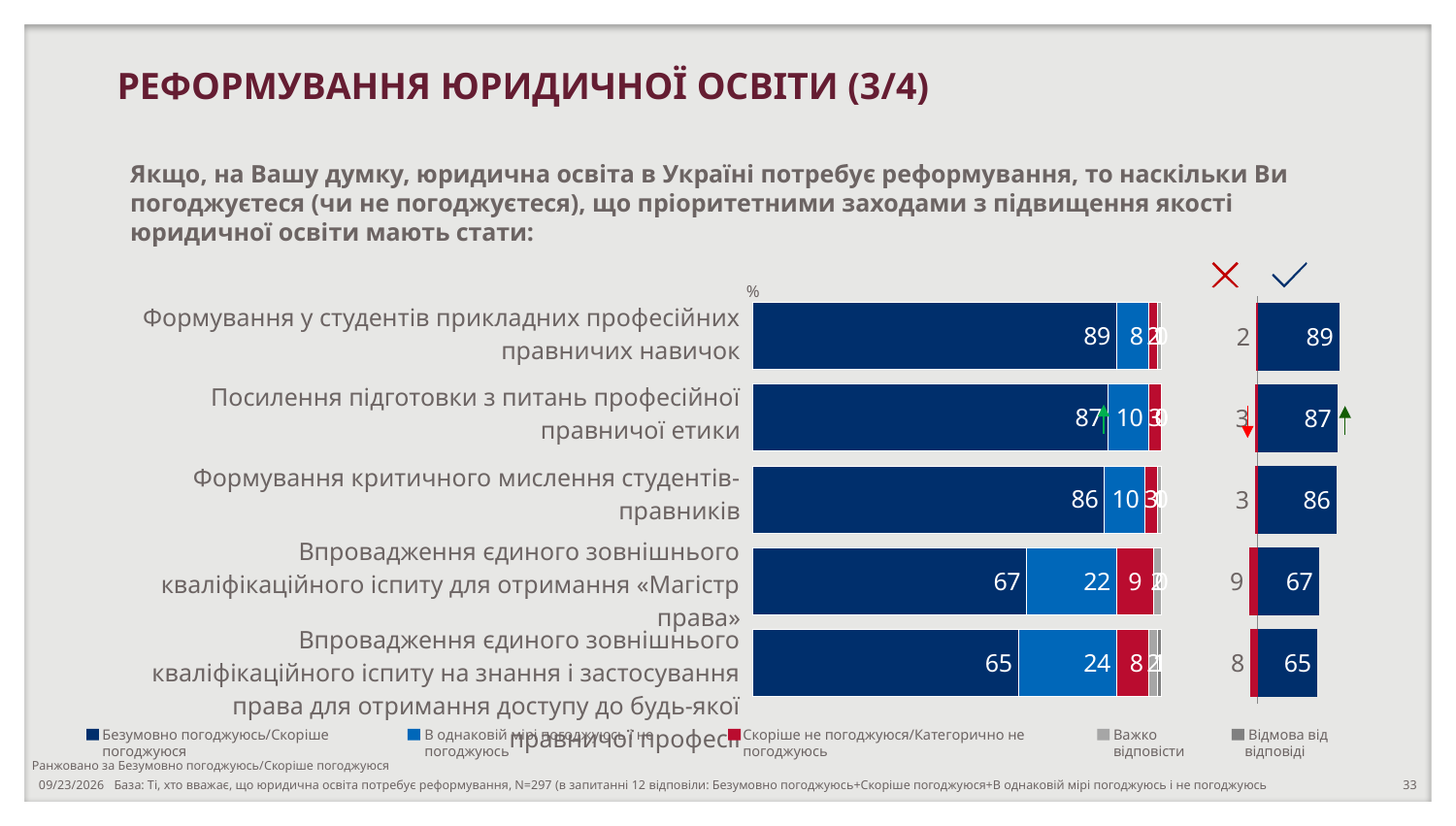
How many categories are shown in the stacked bar chart? 5 In the right-hand summary columns, what is the value under the X mark for «Впровадження єдиного зовнішнього кваліфікаційного іспиту для отримання «Магістр права»»? 9 What type of chart is shown on the slide? Stacked bar chart In the stacked bar chart, what is the value of «В однаковій мірі погоджуюсь і не погоджуюсь» for «Впровадження єдиного зовнішнього кваліфікаційного іспиту для отримання «Магістр права»»? 22 In the stacked bar chart, what is the value of «Безумовно погоджуюсь/Скоріше погоджуюся» for «Формування у студентів прикладних професійних правничих навичок»? 89 In the stacked bar chart, what is the value of «Безумовно погоджуюсь/Скоріше погоджуюся» for «Посилення підготовки з питань професійної правничої етики»? 87 How many series does the legend of the stacked bar chart list? 5 In the stacked bar chart, what is the difference between the «Безумовно погоджуюсь/Скоріше погоджуюся» values for «Формування у студентів прикладних професійних правничих навичок» and for the last category (доступ до будь-якої правничої професії)? 24 In the stacked bar chart, which has the larger «Безумовно погоджуюсь/Скоріше погоджуюся» value: «Формування критичного мислення студентів-правників» or «Впровадження єдиного зовнішнього кваліфікаційного іспиту для отримання «Магістр права»»? Формування критичного мислення студентів-правників In the stacked bar chart, which category has the highest value for «Безумовно погоджуюсь/Скоріше погоджуюся»? Формування у студентів прикладних професійних правничих навичок In the stacked bar chart, what is the value of «В однаковій мірі погоджуюсь і не погоджуюсь» for the last category (іспит для отримання доступу до будь-якої правничої професії)? 24 In the stacked bar chart, which category has the lowest value for «Безумовно погоджуюсь/Скоріше погоджуюся»? Впровадження єдиного зовнішнього кваліфікаційного іспиту на знання і застосування права для отримання доступу до будь-якої правничої професії